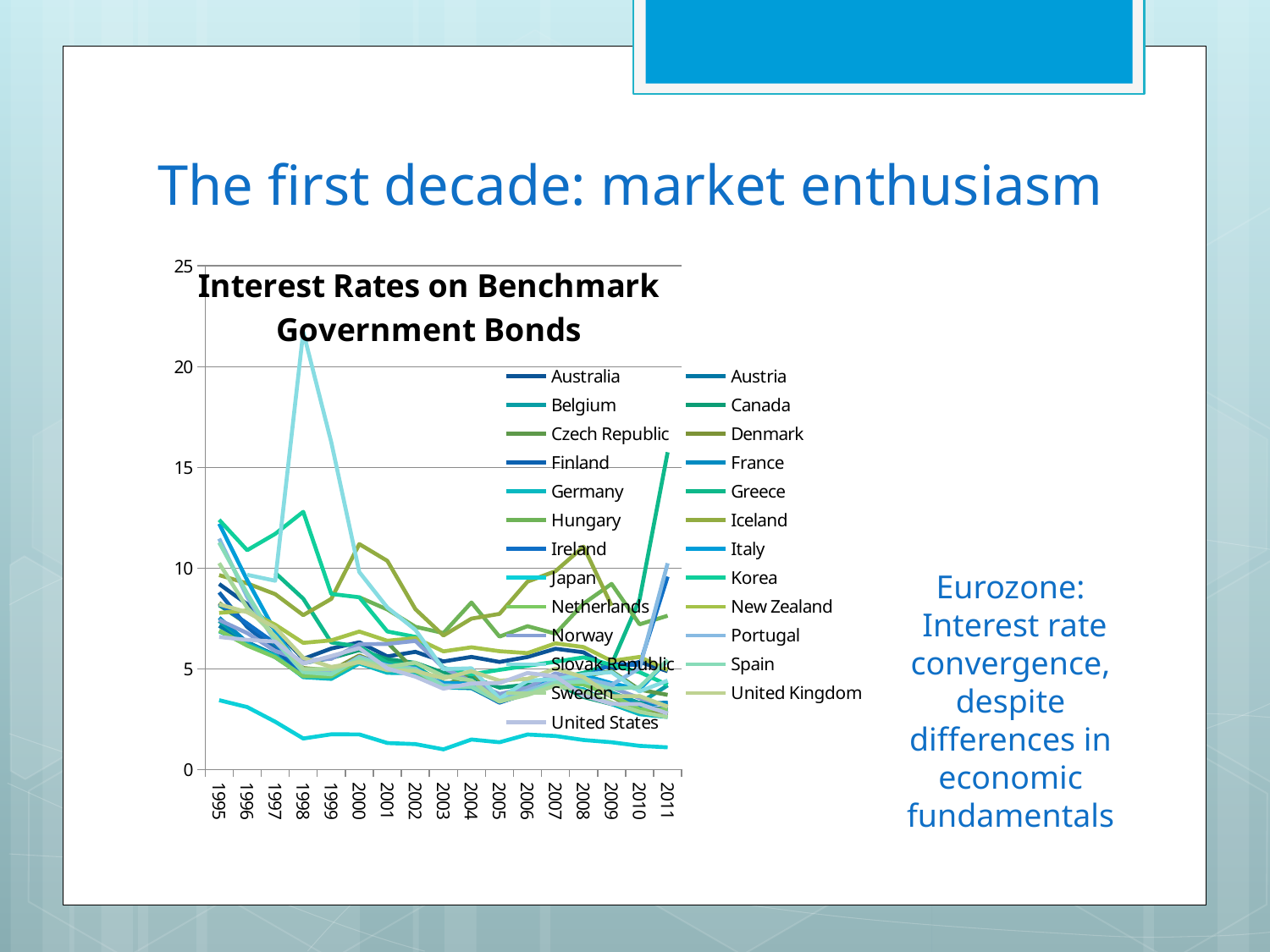
Is the highest value plotted in 2003 greater or less than 10? less Do most of the lines rise or fall between 1995 and 2005? fall What kind of chart is shown on the slide? Line chart What is the first year shown on the x axis of the chart? 1995 What is the title of the chart? Interest Rates on Benchmark Government Bonds Is the highest value plotted in 2011 greater or less than 15? greater What is the maximum value shown on the y axis of the chart? 25 Is the highest value plotted in 1998 greater or less than 20? greater How many years are plotted along the x axis of the chart? 17 How many series does the chart's legend list? 25 What is the last year shown on the x axis of the chart? 2011